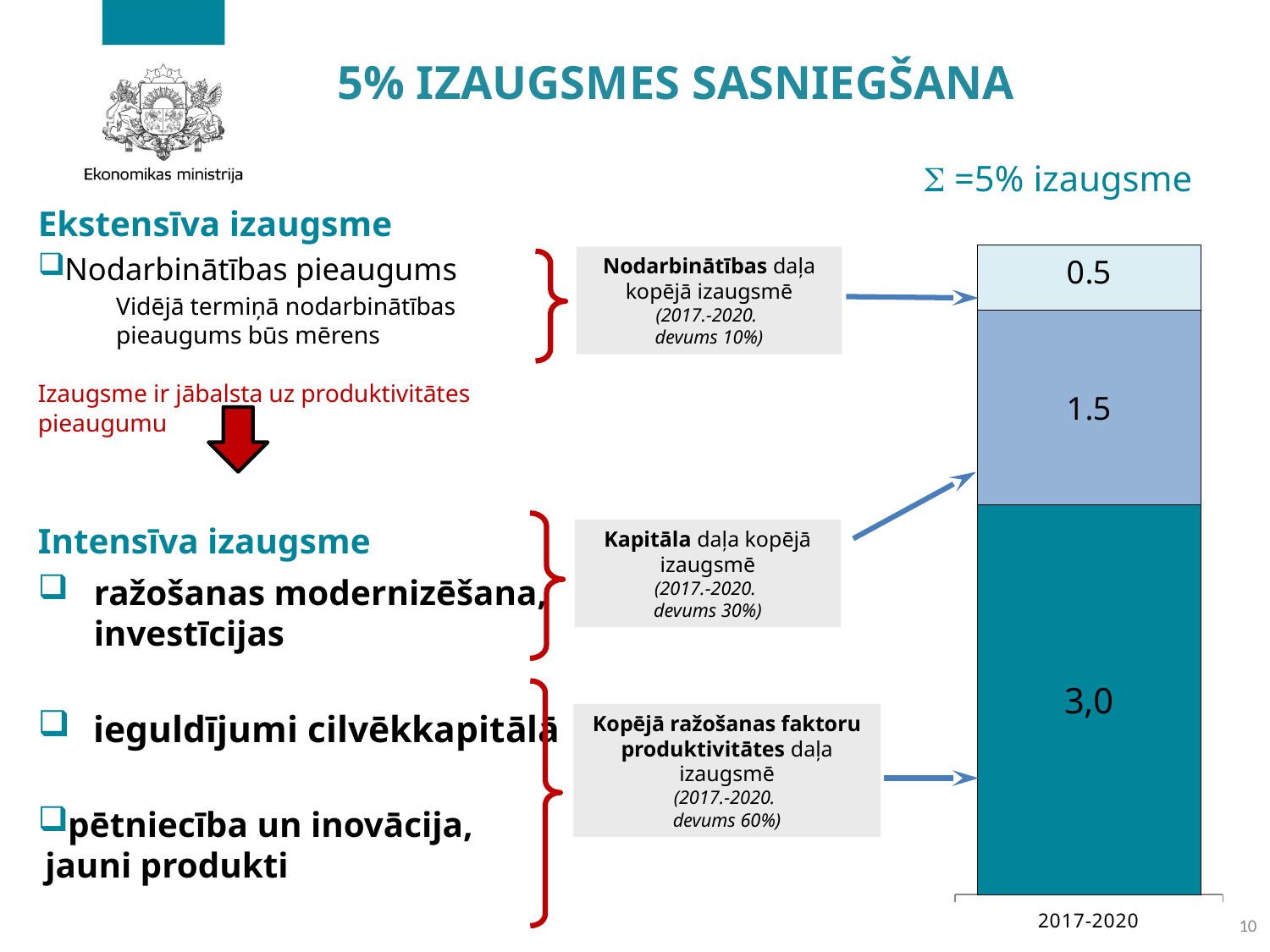
What is the difference between the bottom segment (3,0) and the middle segment (1.5) of the stacked bar? 1.5 What is the total of the stacked bar? 5 Which is larger: the middle segment (1.5) or the top segment (0.5) of the stacked bar? the middle segment (1.5) How many categories are shown on the x axis of the chart? 1 Which segment of the stacked bar has the largest value? the bottom segment (3,0) What value is printed on the bottom (dark teal) segment of the stacked bar? 3,0 Which segment of the stacked bar has the smallest value? the top segment (0.5) What value is printed on the middle segment of the stacked bar? 1.5 How many segments make up the stacked bar? 3 What value is printed on the top (lightest) segment of the stacked bar? 0.5 What is the category label on the x axis of the chart? 2017-2020 What kind of chart is shown on the right of the slide? stacked bar chart